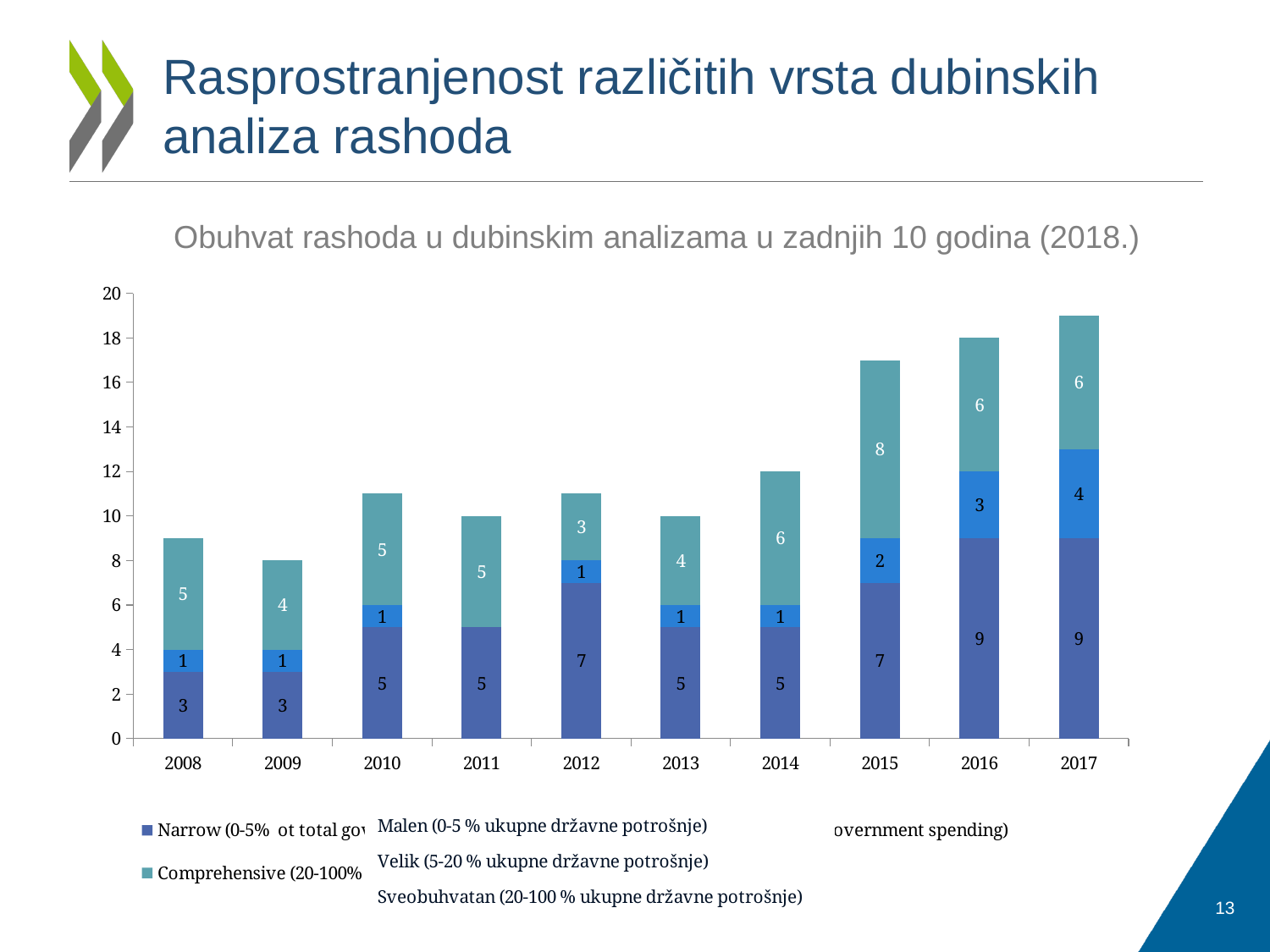
By how much does the Narrow (0-5%) value in 2017 exceed the Narrow value in 2008? 6 What is the value of the Comprehensive (20-100%) series in 2015? 8 What is the total height of the stacked bar for 2017? 19 What is the value of the middle series (Velik, 5-20%) in 2017? 4 Which year has the shortest stacked bar? 2009 Which year has the larger Comprehensive (20-100%) value, 2015 or 2016? 2015 What is the value of the Narrow (0-5%) series in 2016? 9 Does the Narrow (0-5%) series rise or fall from 2014 to 2017? Rise How many years are shown on the x axis? 10 What kind of chart is shown on the slide? Stacked bar chart Which year has the tallest stacked bar? 2017 What is the total height of the stacked bar for 2008? 9